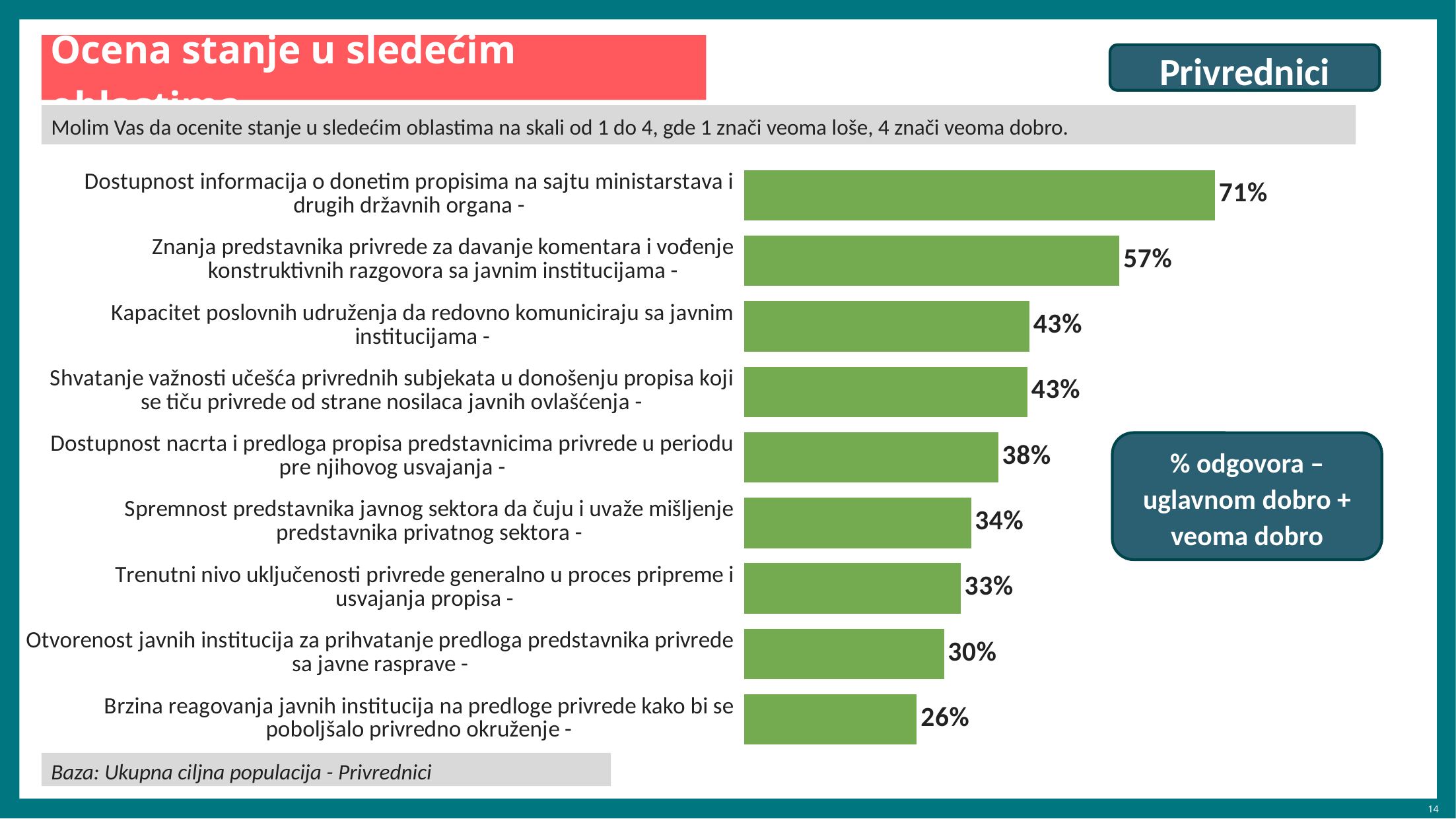
What percentage is shown for 'Brzina reagovanja javnih institucija na predloge privrede kako bi se poboljšalo privredno okruženje'? 26% Which category has the lowest percentage? Brzina reagovanja javnih institucija na predloge privrede kako bi se poboljšalo privredno okruženje What colour are the bars in the chart? Green What percentage is shown for 'Dostupnost informacija o donetim propisima na sajtu ministarstava i drugih državnih organa'? 71% What is the difference in percentage points between 'Dostupnost informacija o donetim propisima...' (71%) and 'Znanja predstavnika privrede za davanje komentara...' (57%)? 14 How many categories are shown in the bar chart? 9 What is the difference in percentage points between 'Trenutni nivo uključenosti privrede generalno u proces pripreme i usvajanja propisa' (33%) and 'Brzina reagovanja javnih institucija...' (26%)? 7 What percentage is shown for 'Spremnost predstavnika javnog sektora da čuju i uvaže mišljenje predstavnika privatnog sektora'? 34% Which is larger: the value for 'Dostupnost nacrta i predloga propisa predstavnicima privrede u periodu pre njihovog usvajanja' or the value for 'Otvorenost javnih institucija za prihvatanje predloga predstavnika privrede sa javne rasprave'? Dostupnost nacrta i predloga propisa predstavnicima privrede u periodu pre njihovog usvajanja Which category has the highest percentage? Dostupnost informacija o donetim propisima na sajtu ministarstava i drugih državnih organa What kind of chart is shown on the slide? Bar chart